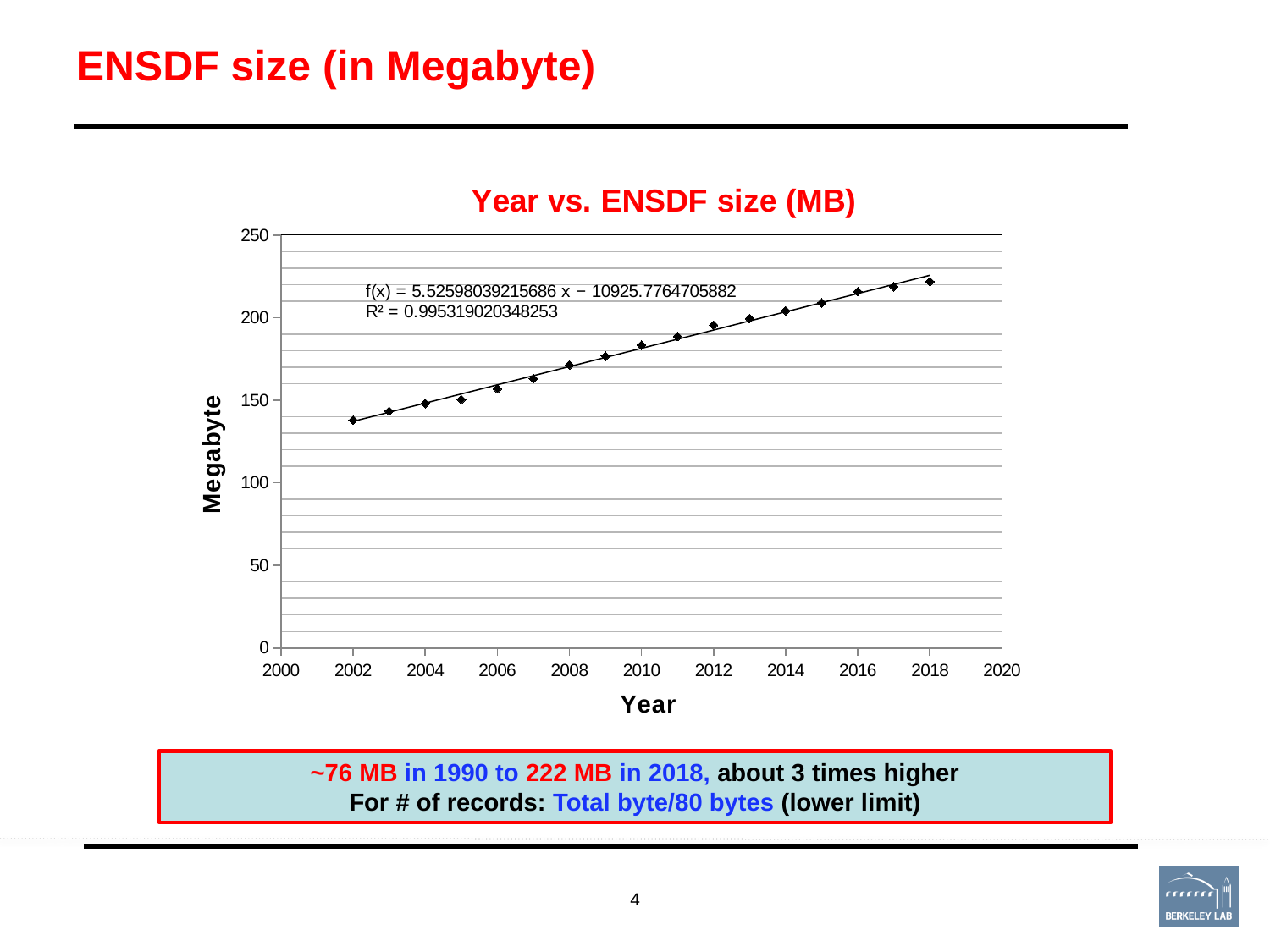
Is the value for 2002 greater or less than 150? less Is the value for 2010 greater or less than 150? greater How many data points are plotted in the chart? 17 What kind of chart is shown on the slide? scatter chart Is the value for 2008 greater or less than 200? less What is the title of the chart? Year vs. ENSDF size (MB) Which year has the larger ENSDF size, 2004 or 2010? 2010 Which year has the lowest ENSDF size? 2002 Which year has the highest ENSDF size? 2018 What is the label of the vertical axis? Megabyte Do the plotted values rise or fall as the year increases? rise